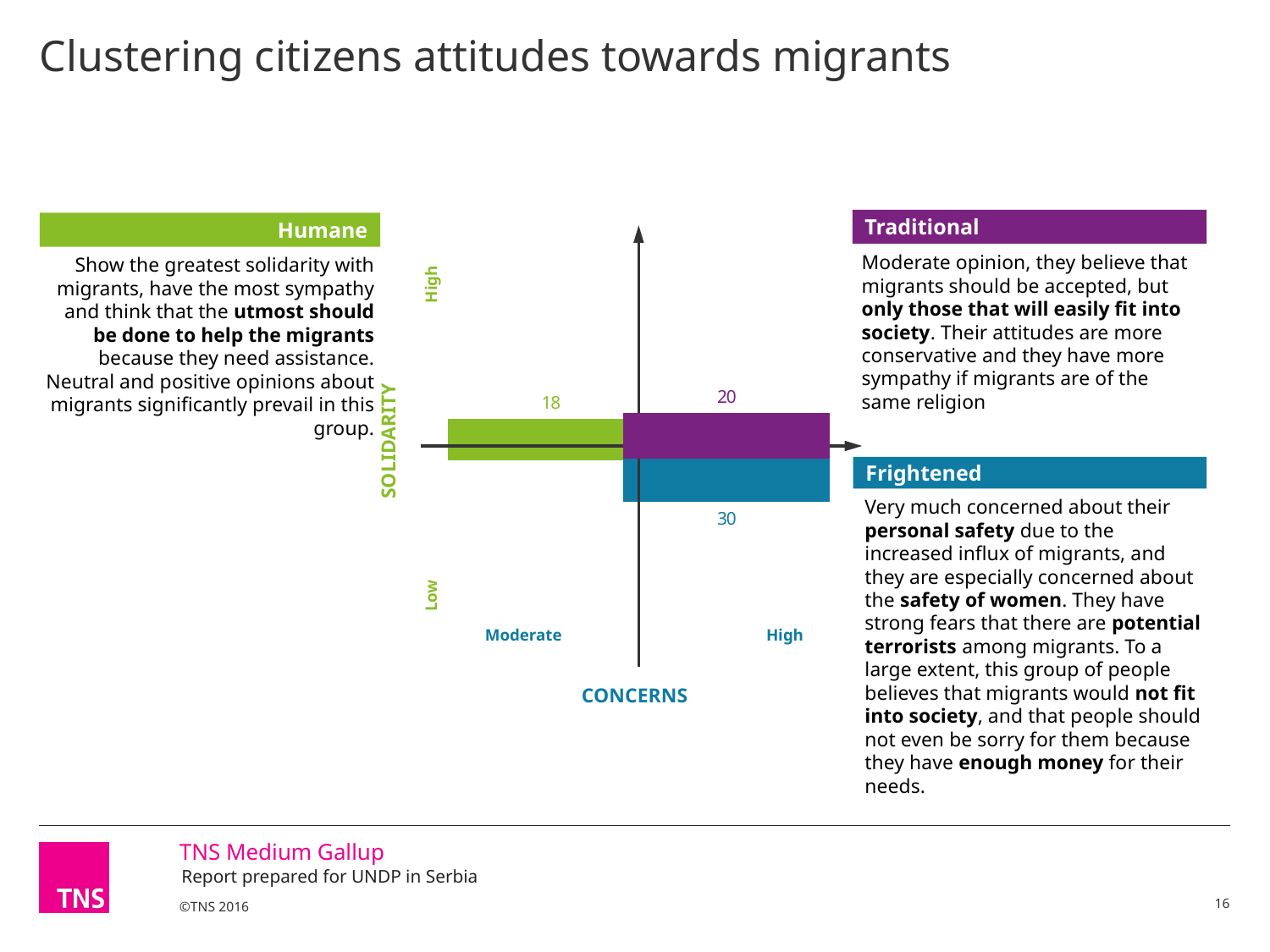
How many groups are plotted on the chart? 3 Which group has the lowest value? Humane What is the total of the three group values shown on the chart? 68 What value is shown for the Frightened group? 30 What value is shown for the Traditional group? 20 Which is larger, the value for Frightened or the value for Traditional? Frightened What is the difference between the Traditional value and the Humane value? 2 What is the label of the vertical axis? SOLIDARITY What is the label of the horizontal axis? CONCERNS What is the difference between the Frightened value and the Humane value? 12 What value is shown for the Humane group? 18 Which group has the highest value? Frightened